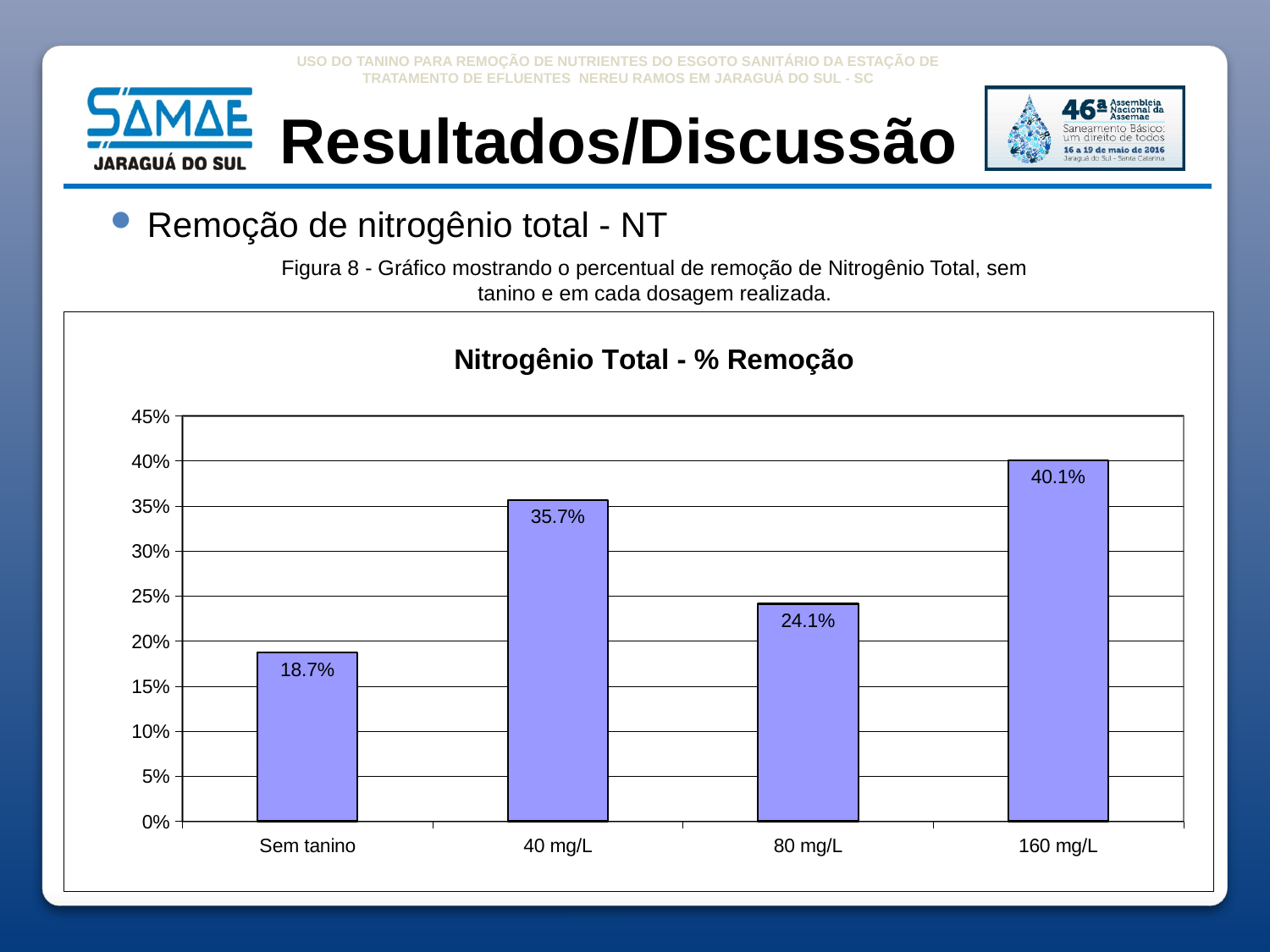
Which has a higher removal percentage, 40 mg/L or 80 mg/L? 40 mg/L What is the difference between the removal percentages for 160 mg/L and 40 mg/L? 4.4% How many categories are shown on the x axis? 4 What is the title of the chart? Nitrogênio Total - % Remoção Is the value for 80 mg/L greater or less than 25%? less What kind of chart is shown? bar chart What is the removal percentage for 80 mg/L? 24.1% Which category has the highest removal percentage? 160 mg/L Which category has the lowest removal percentage? Sem tanino What is the removal percentage for Sem tanino? 18.7% What is the removal percentage for 40 mg/L? 35.7% What is the removal percentage for 160 mg/L? 40.1%